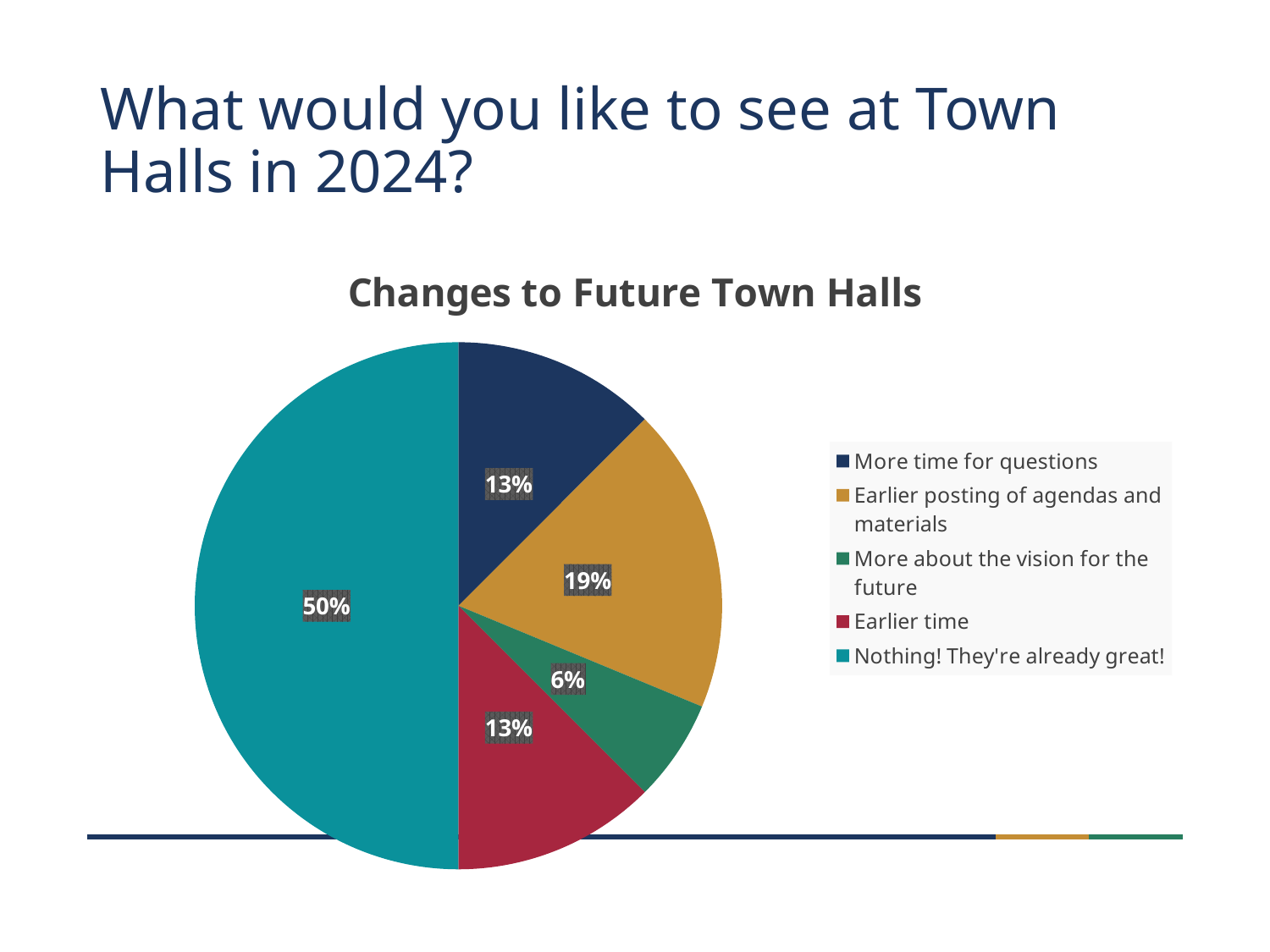
What share of the pie is "Earlier posting of agendas and materials"? 19% What kind of chart is shown on the slide? Pie chart What share of the pie is "Earlier time"? 13% Which is larger, the slice for "Earlier posting of agendas and materials" or the slice for "Earlier time"? Earlier posting of agendas and materials Which category has the smallest slice of the pie? More about the vision for the future What share of the pie is "Nothing! They're already great!"? 50% How many categories does the legend list? 5 What is the title of the chart? Changes to Future Town Halls What is the difference in percentage points between "Earlier posting of agendas and materials" and "More about the vision for the future"? 13 percentage points Which category has the largest slice of the pie? Nothing! They're already great!